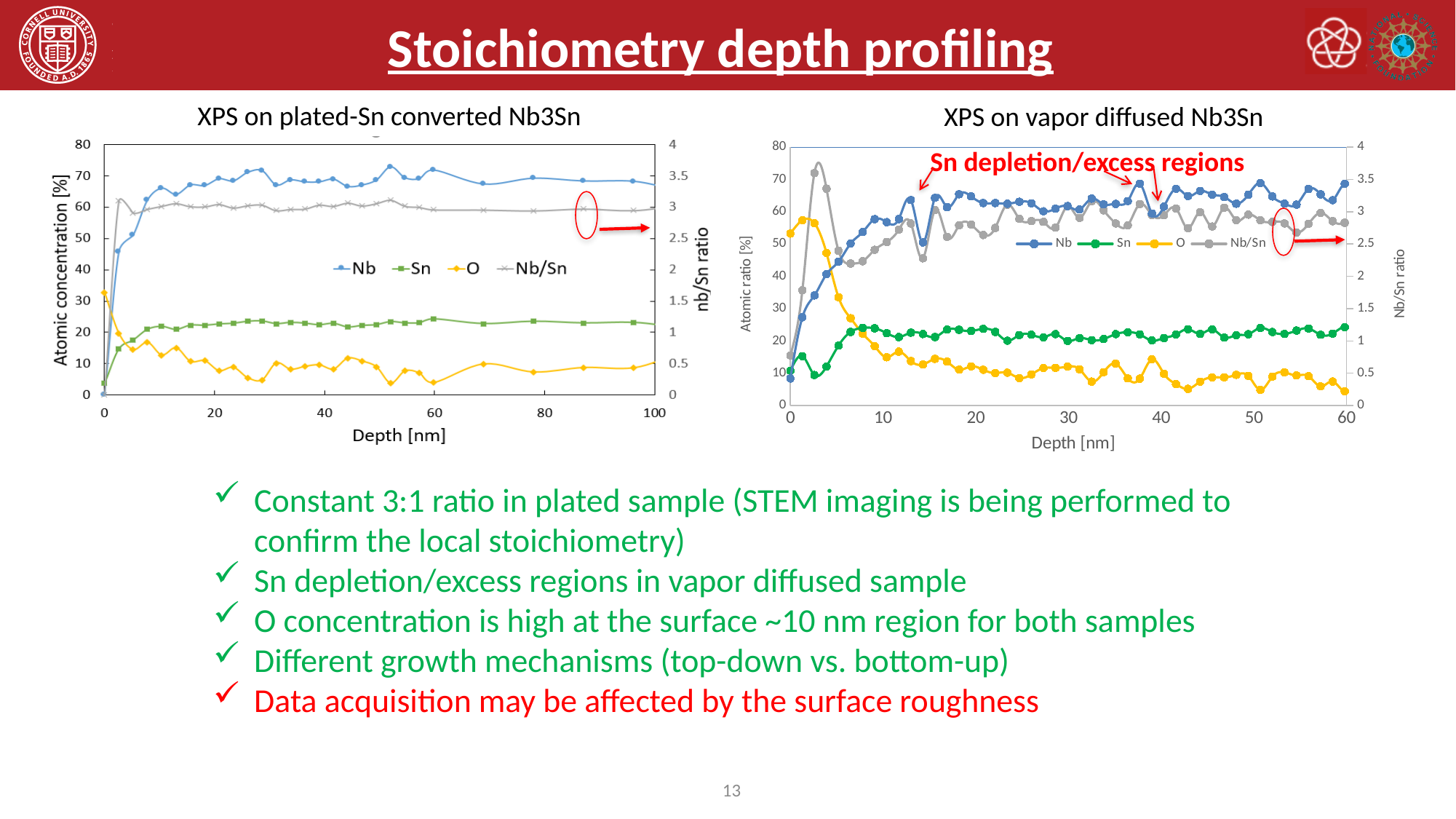
In the 'XPS on vapor diffused Nb3Sn' chart, at a depth of 40 nm, which is larger: Sn or O? Sn In the 'XPS on vapor diffused Nb3Sn' chart, is the O value at a depth of 60 nm greater or less than 10? less In the 'XPS on plated-Sn converted Nb3Sn' chart, is the O value at a depth of 0 nm greater or less than 20? greater In the 'XPS on plated-Sn converted Nb3Sn' chart, which series are listed in the legend? Nb, Sn, O, Nb/Sn In the 'XPS on vapor diffused Nb3Sn' chart, does the O series generally rise or fall as depth increases? fall In the 'XPS on plated-Sn converted Nb3Sn' chart, at a depth of 60 nm, which is larger: Nb or Sn? Nb What is the x-axis title of the 'XPS on vapor diffused Nb3Sn' chart? Depth [nm] In the 'XPS on plated-Sn converted Nb3Sn' chart, is the Sn value at a depth of 40 nm greater or less than 30? less What type of chart is the 'XPS on plated-Sn converted Nb3Sn' chart? line chart How many series does the legend of the 'XPS on vapor diffused Nb3Sn' chart list? 4